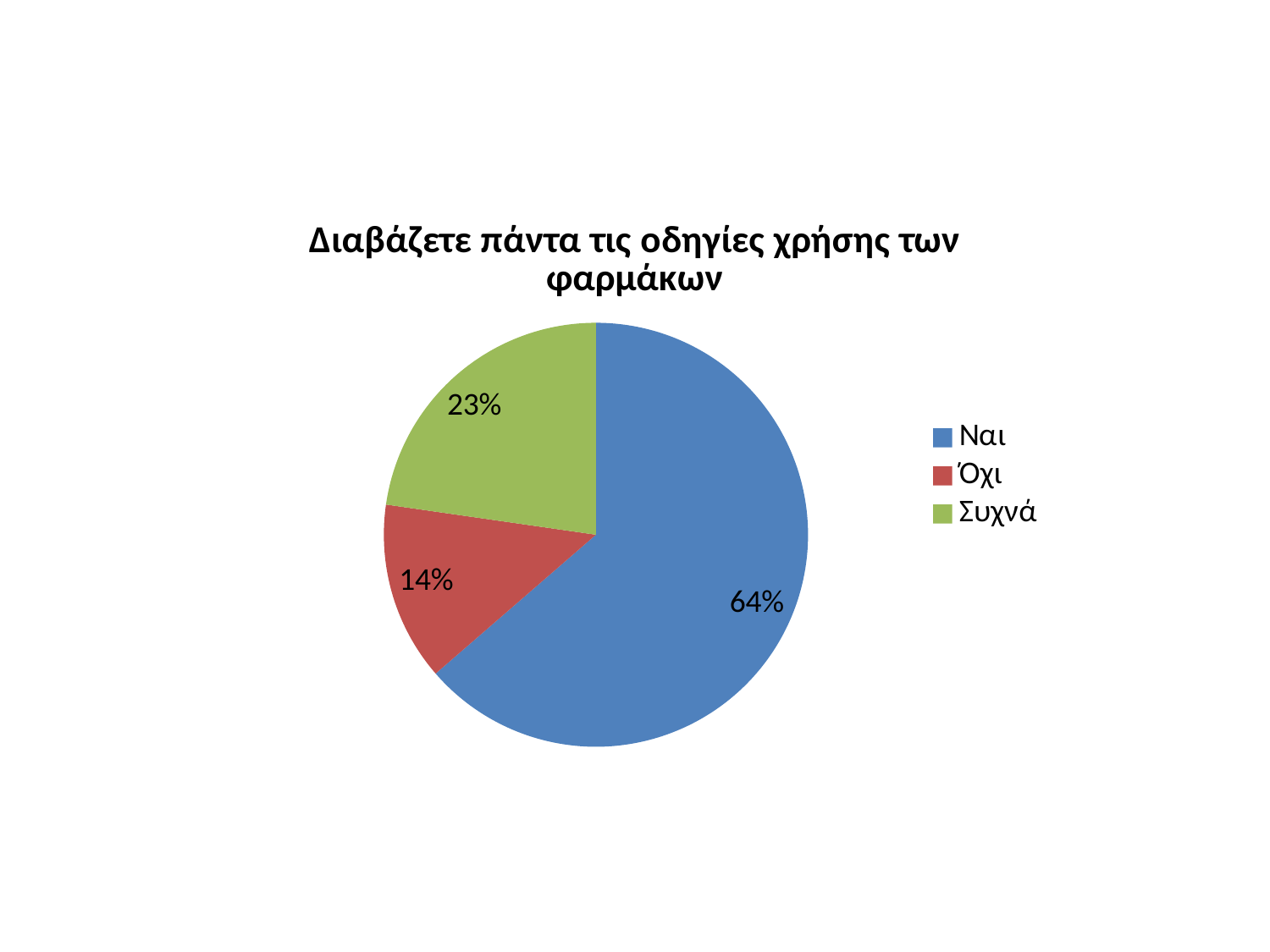
How many categories does the pie chart have? 3 What colour is the 'Συχνά' slice? Green What share of the pie does the 'Συχνά' slice represent? 23% What is the difference in percentage points between the 'Ναι' and 'Συχνά' slices? 41 What kind of chart is shown on the slide? Pie chart What share of the pie does the 'Όχι' slice represent? 14% Which slice is larger, 'Όχι' or 'Συχνά'? Συχνά Which category has the largest slice of the pie? Ναι What is the difference in percentage points between the 'Συχνά' and 'Όχι' slices? 9 What is the title of the chart? Διαβάζετε πάντα τις οδηγίες χρήσης των φαρμάκων Which category has the smallest slice of the pie? Όχι What share of the pie does the 'Ναι' slice represent? 64%